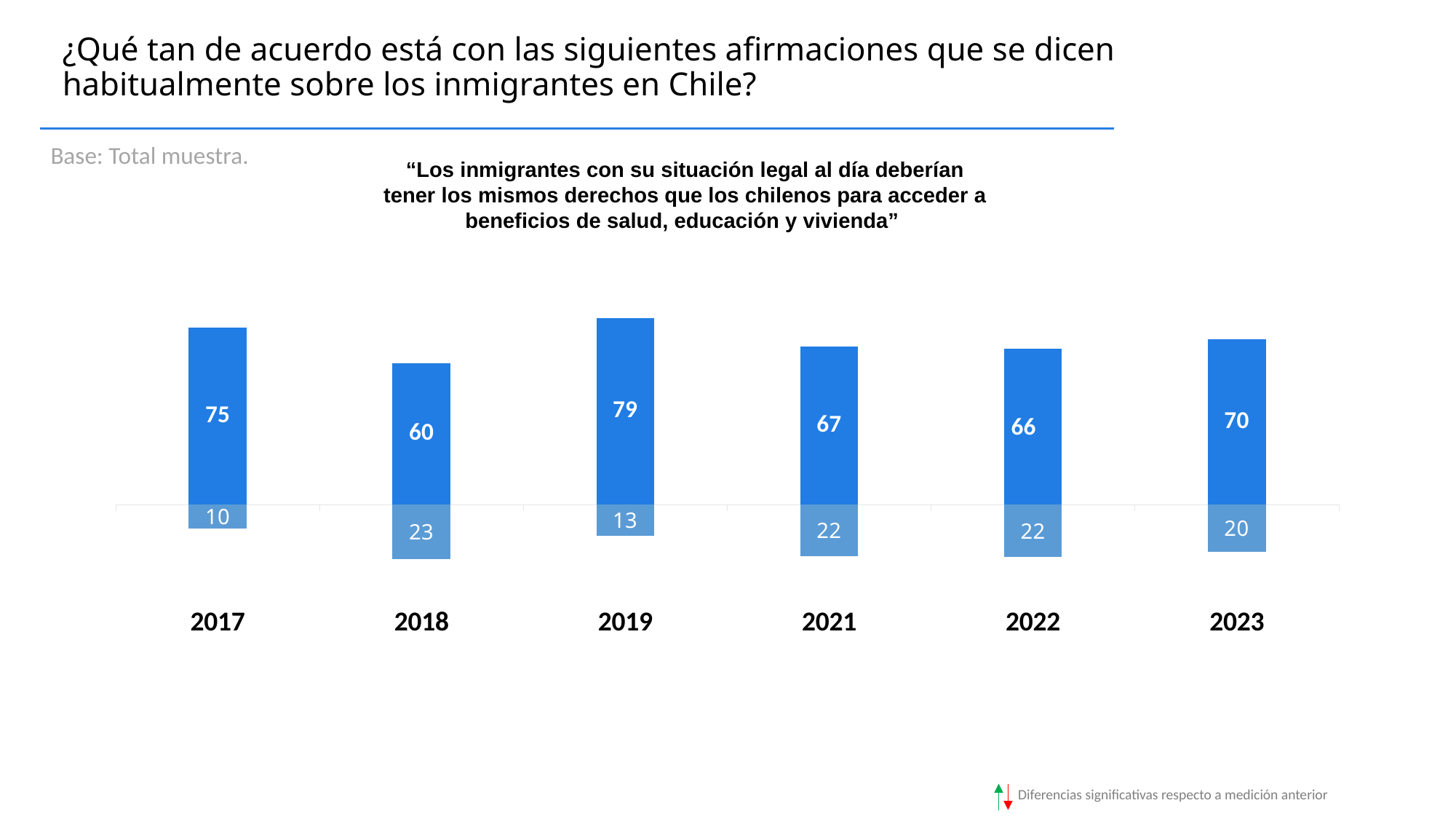
What is the value of the dark blue bar above the axis for 2023? 70 What is the difference between the light blue bar values for 2018 and 2017? 13 What is the value of the dark blue bar above the axis for 2019? 79 Do the dark blue bar values rise or fall from 2021 to 2023? Rise What is the value of the light blue bar below the axis for 2018? 23 How many years are shown on the x axis of the chart? 6 Which year has the highest value in the dark blue bars above the axis? 2019 What kind of chart is shown on the slide? Bar chart Which year has the lowest value in the light blue bars below the axis? 2017 Which year has the lowest value in the dark blue bars above the axis? 2018 What is the difference between the dark blue bar values for 2019 and 2018? 19 Which is larger, the dark blue bar value for 2017 or for 2023? 2017